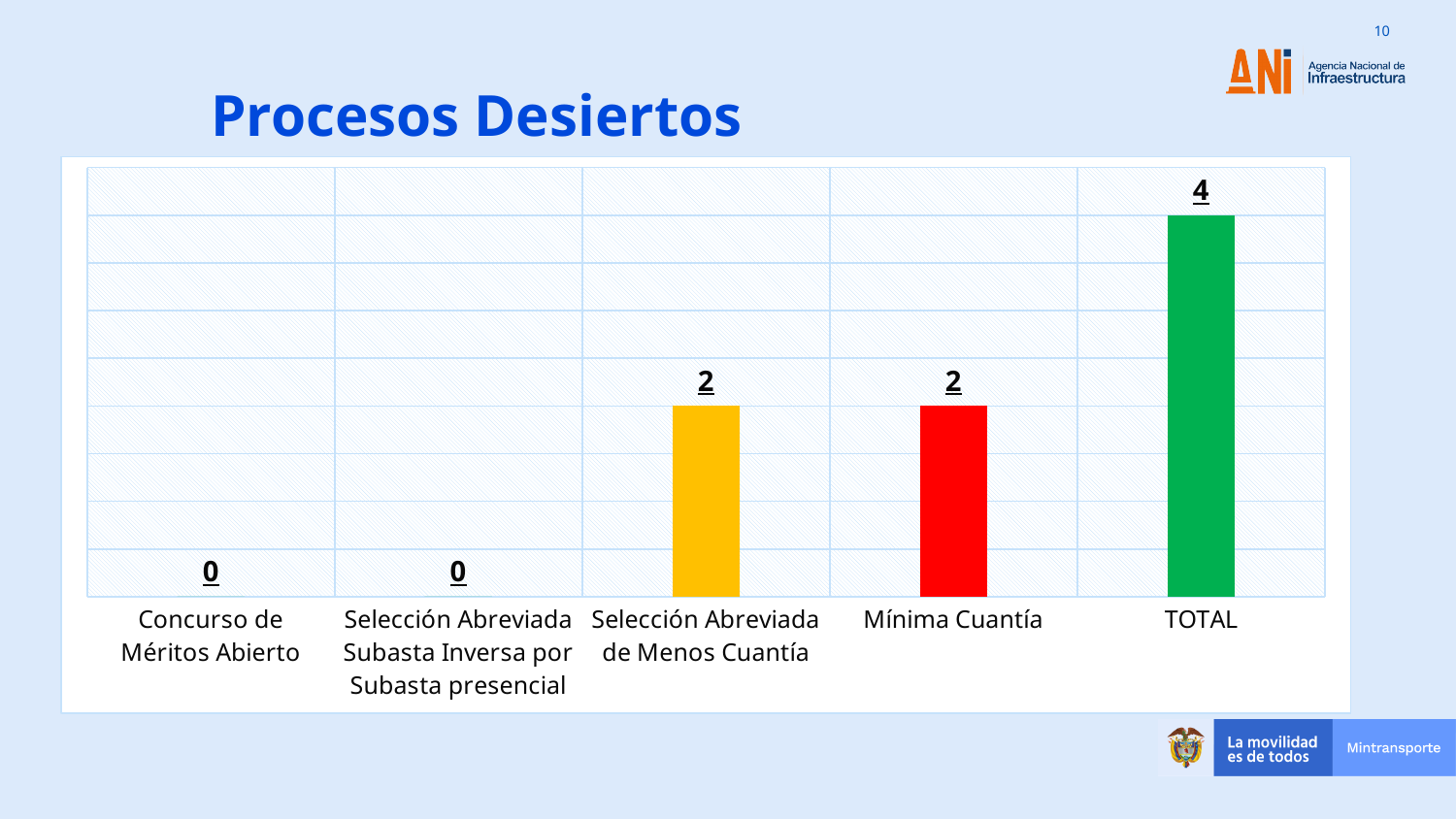
What is the value for Concurso de Méritos Abierto? 0 What kind of chart is shown on the slide? Bar chart Which category has the highest value? TOTAL What is the difference between the values for TOTAL and Mínima Cuantía? 2 What is the value for Selección Abreviada Subasta Inversa por Subasta presencial? 0 What colour is the bar for TOTAL? Green How many categories are shown on the x axis? 5 What is the title of the slide? Procesos Desiertos What is the value for Selección Abreviada de Menos Cuantía? 2 What is the value for Mínima Cuantía? 2 Which is larger, the value for Mínima Cuantía or the value for Concurso de Méritos Abierto? Mínima Cuantía What is the value for TOTAL? 4